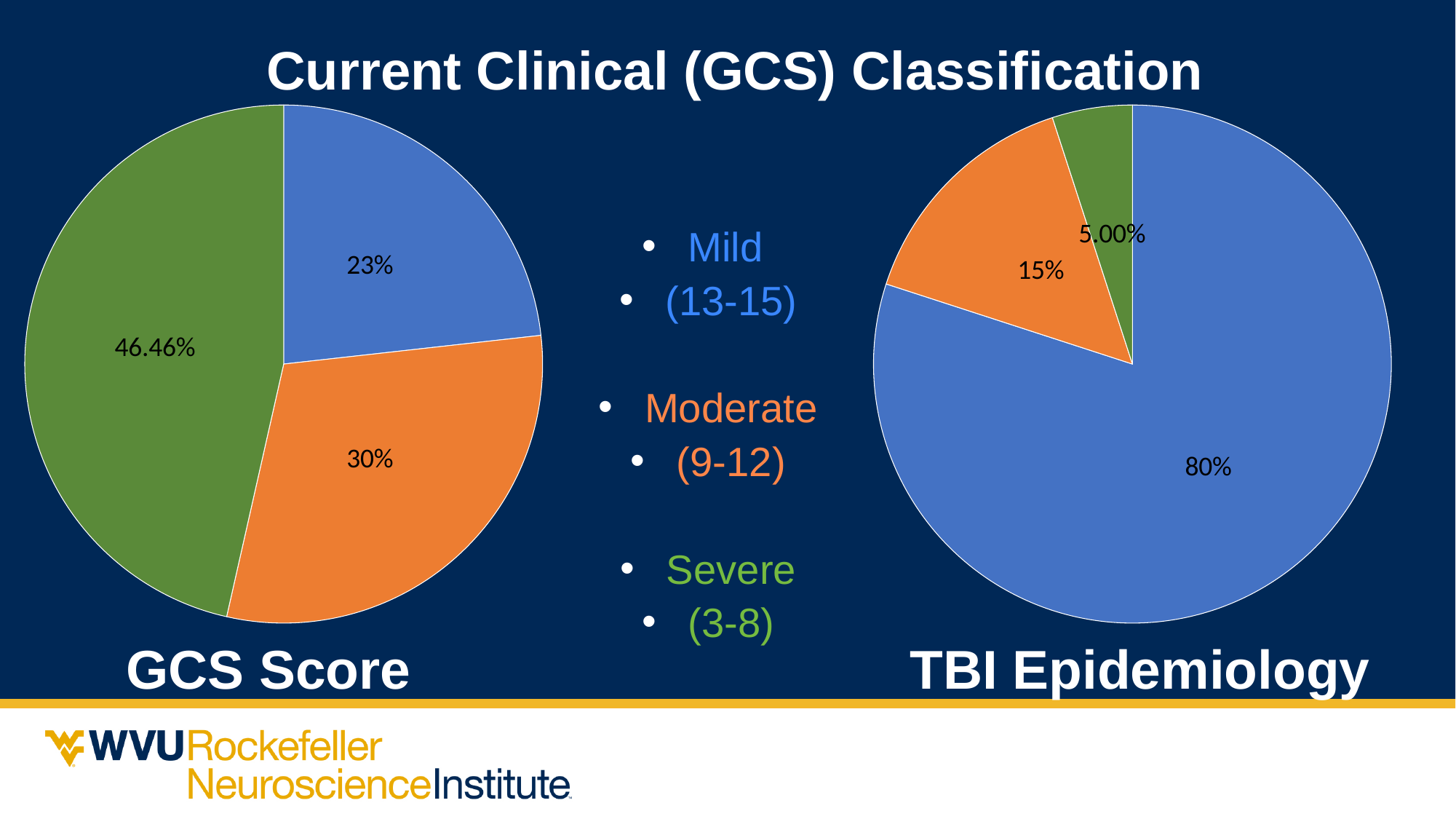
In the GCS Score pie chart, which category has the largest slice? Severe (3-8) In the GCS Score pie chart, which category has the smallest slice? Mild (13-15) How many categories does the legend between the two pie charts list? 3 What type of chart is the GCS Score chart on the left? pie chart In the GCS Score pie chart, what percentage is shown for the Severe (3-8) slice? 46.46% In the TBI Epidemiology pie chart, which category has the largest slice? Mild (13-15) In the TBI Epidemiology pie chart, what is the difference between the Mild (13-15) and Moderate (9-12) percentages? 65% In the TBI Epidemiology pie chart, what percentage is shown for the Severe (3-8) slice? 5.00% In the GCS Score pie chart, what percentage is shown for the Moderate (9-12) slice? 30% In the TBI Epidemiology pie chart, what percentage is shown for the Mild (13-15) slice? 80% In the GCS Score pie chart, what percentage is shown for the Mild (13-15) slice? 23% In the TBI Epidemiology pie chart, what percentage is shown for the Moderate (9-12) slice? 15%